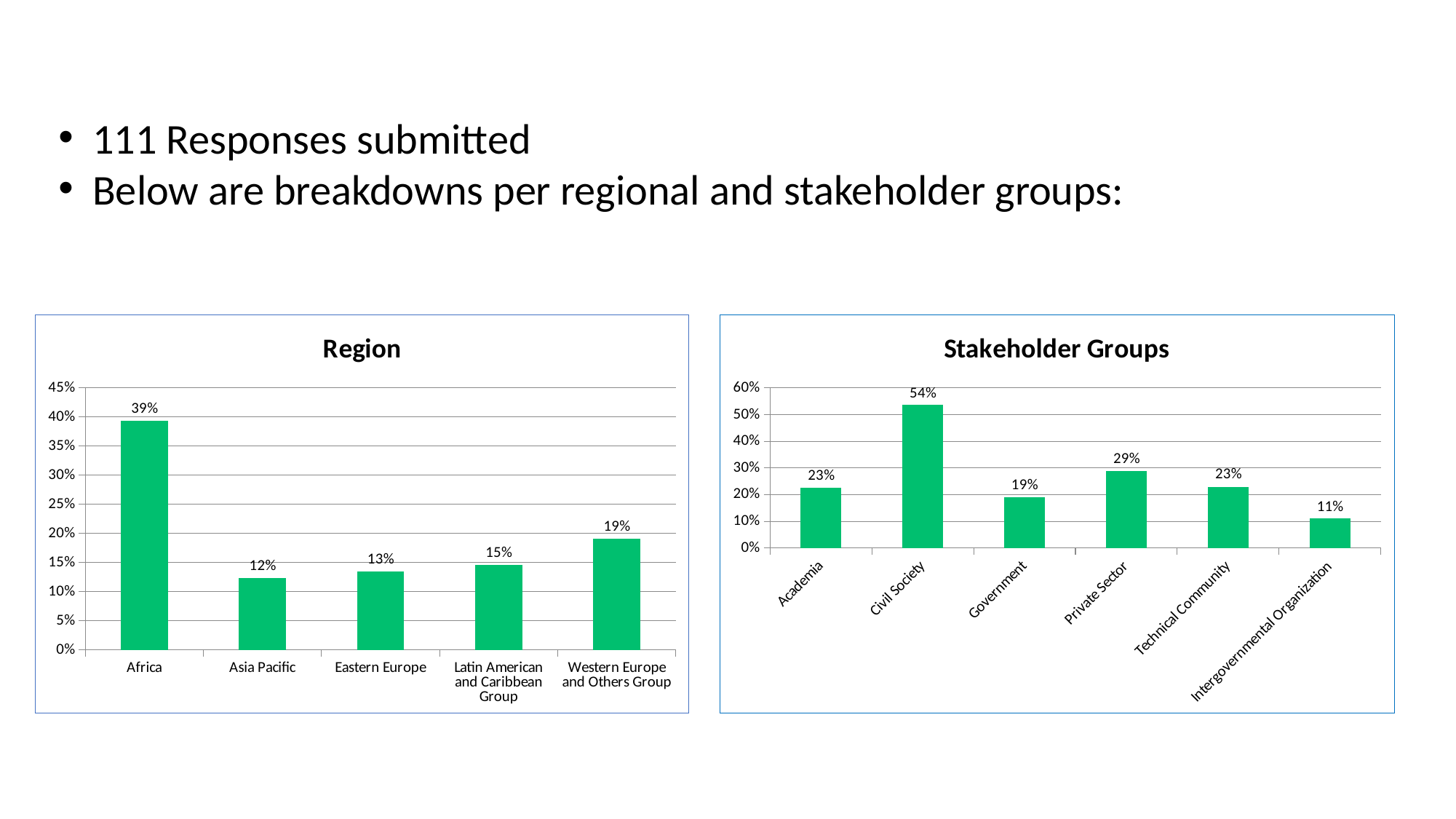
What is the title of the chart on the left side of the slide? Region In the Region chart, how many regions are shown? 5 In the Region chart, which is larger, Eastern Europe or Latin American and Caribbean Group? Latin American and Caribbean Group What type of chart is the Stakeholder Groups chart? Bar chart In the Stakeholder Groups chart, what is the value for Civil Society? 54% In the Region chart, what is the difference between Africa and Western Europe and Others Group? 20% In the Region chart, which region has the lowest value? Asia Pacific In the Stakeholder Groups chart, what is the difference between Private Sector and Government? 10% In the Stakeholder Groups chart, which group has the lowest value? Intergovernmental Organization In the Stakeholder Groups chart, how many stakeholder groups are shown? 6 In the Region chart, what is the value for Africa? 39% In the Stakeholder Groups chart, which group has the highest value? Civil Society